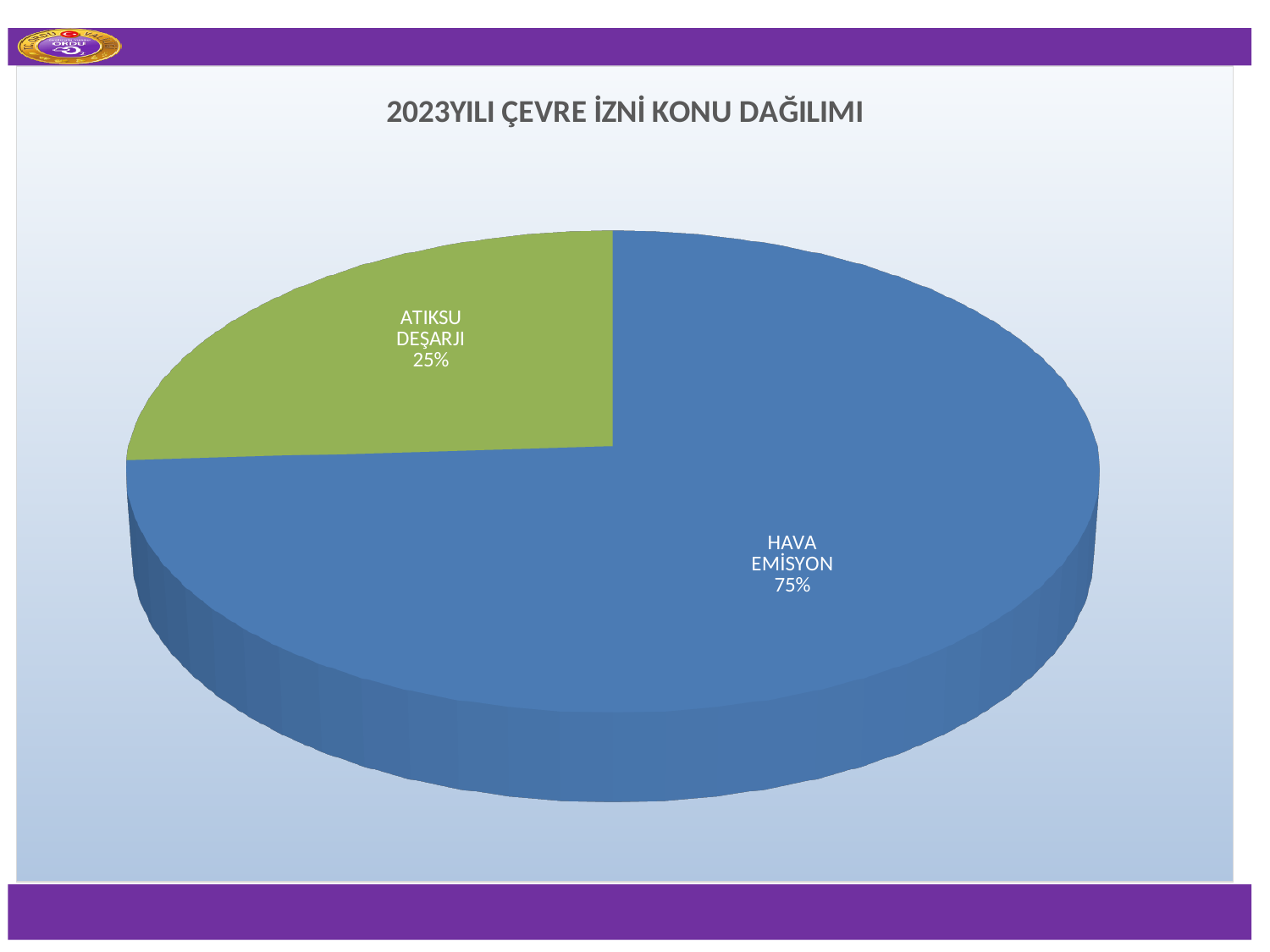
What share of the pie does HAVA EMİSYON take? 75% What share of the pie does ATIKSU DEŞARJI take? 25% What is the difference in percentage points between HAVA EMİSYON and ATIKSU DEŞARJI? 50 What kind of chart is shown on the slide? pie chart How many slices does the pie chart have? 2 What colour is the HAVA EMİSYON slice? blue What is the title of the chart? 2023YILI ÇEVRE İZNİ KONU DAĞILIMI Which is larger, the share for ATIKSU DEŞARJI or the share for HAVA EMİSYON? HAVA EMİSYON Which category has the smallest slice of the pie? ATIKSU DEŞARJI Which category has the largest slice of the pie? HAVA EMİSYON